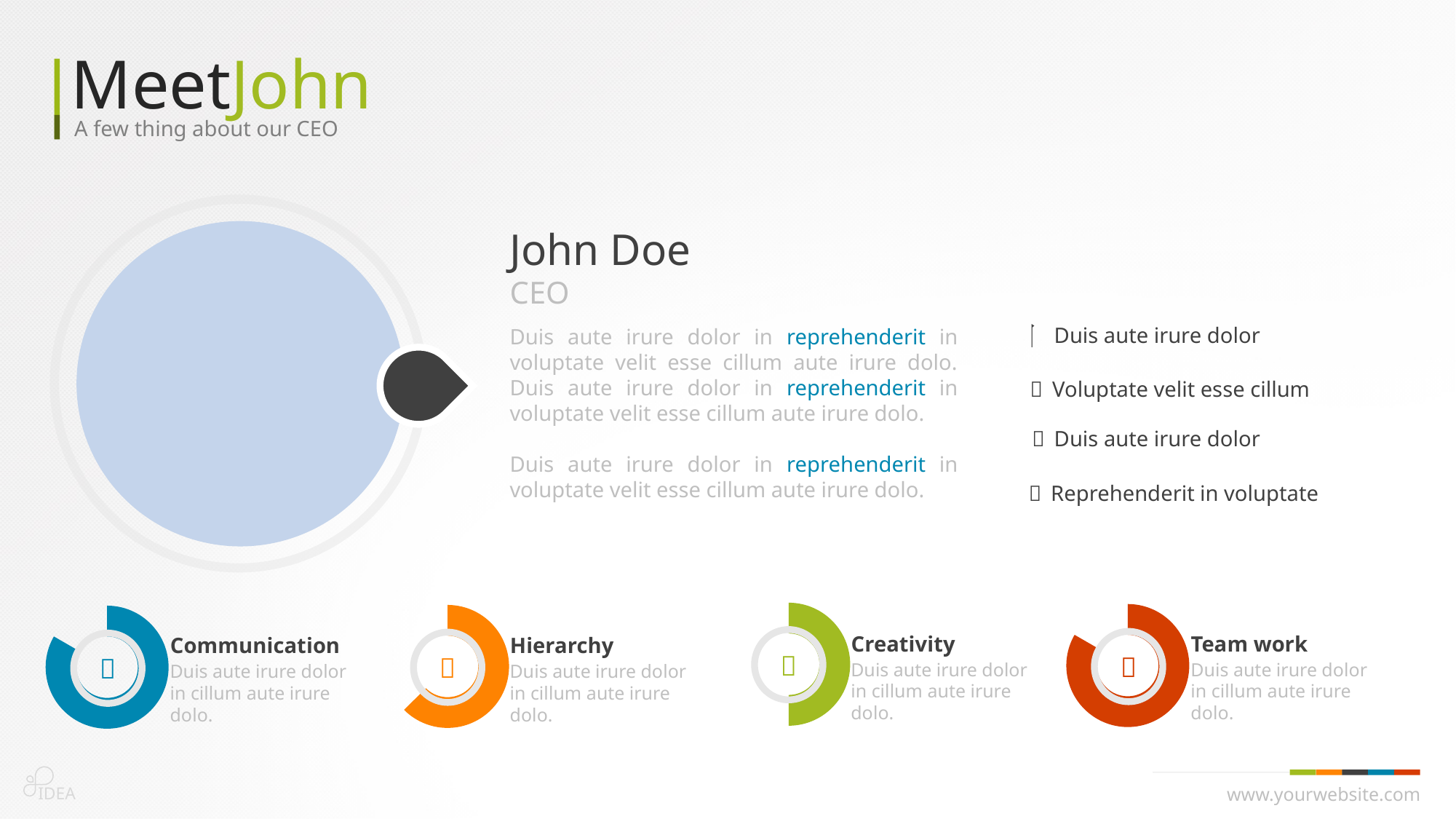
Which of the four bottom ring indicators has the smallest filled portion? Creativity Which label belongs to the orange ring? Hierarchy How many ring indicators are shown along the bottom of the slide? 4 What colour is the Communication ring? blue What kind of chart are the four indicators at the bottom of the slide? doughnut (ring) chart Which ring is more filled, Communication or Creativity? Communication